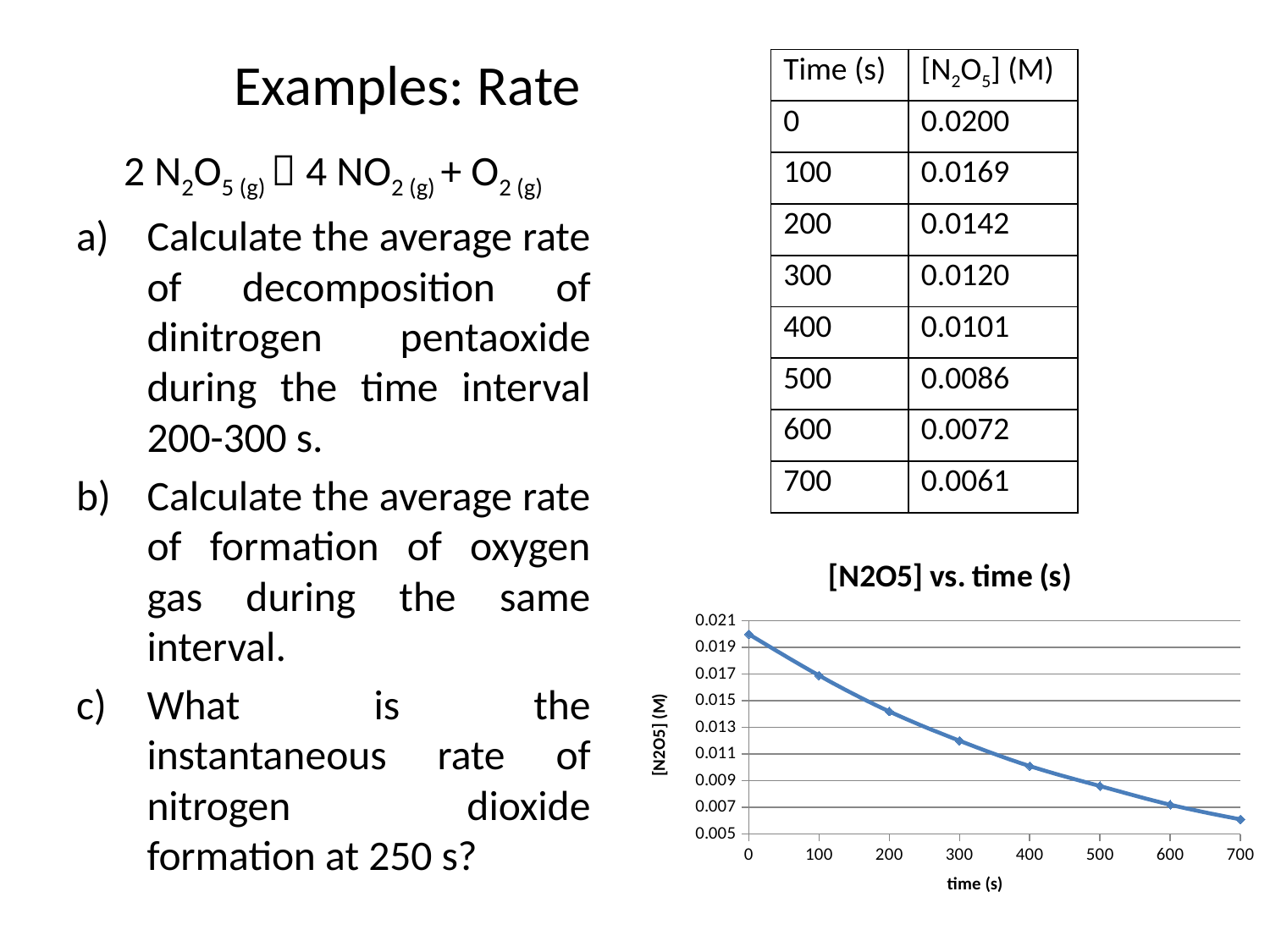
What is the label on the x axis of the chart? time (s) What is the title of the chart? [N2O5] vs. time (s) Is the value for [N2O5] at 500 s greater or less than 0.011? less At which time is [N2O5] lowest on the chart? 700 At which time is [N2O5] highest on the chart? 0 What kind of chart is shown on the slide? line chart Which has a larger [N2O5] value, 200 s or 600 s? 200 s What is the [N2O5] value at 300 s? 0.0120 Do the values on the [N2O5] vs. time (s) chart rise or fall as time increases? fall Is the value for [N2O5] at 100 s greater or less than 0.015? greater How many data points are plotted on the [N2O5] vs. time (s) chart? 8 What is the difference between [N2O5] at 200 s and at 300 s? 0.0022